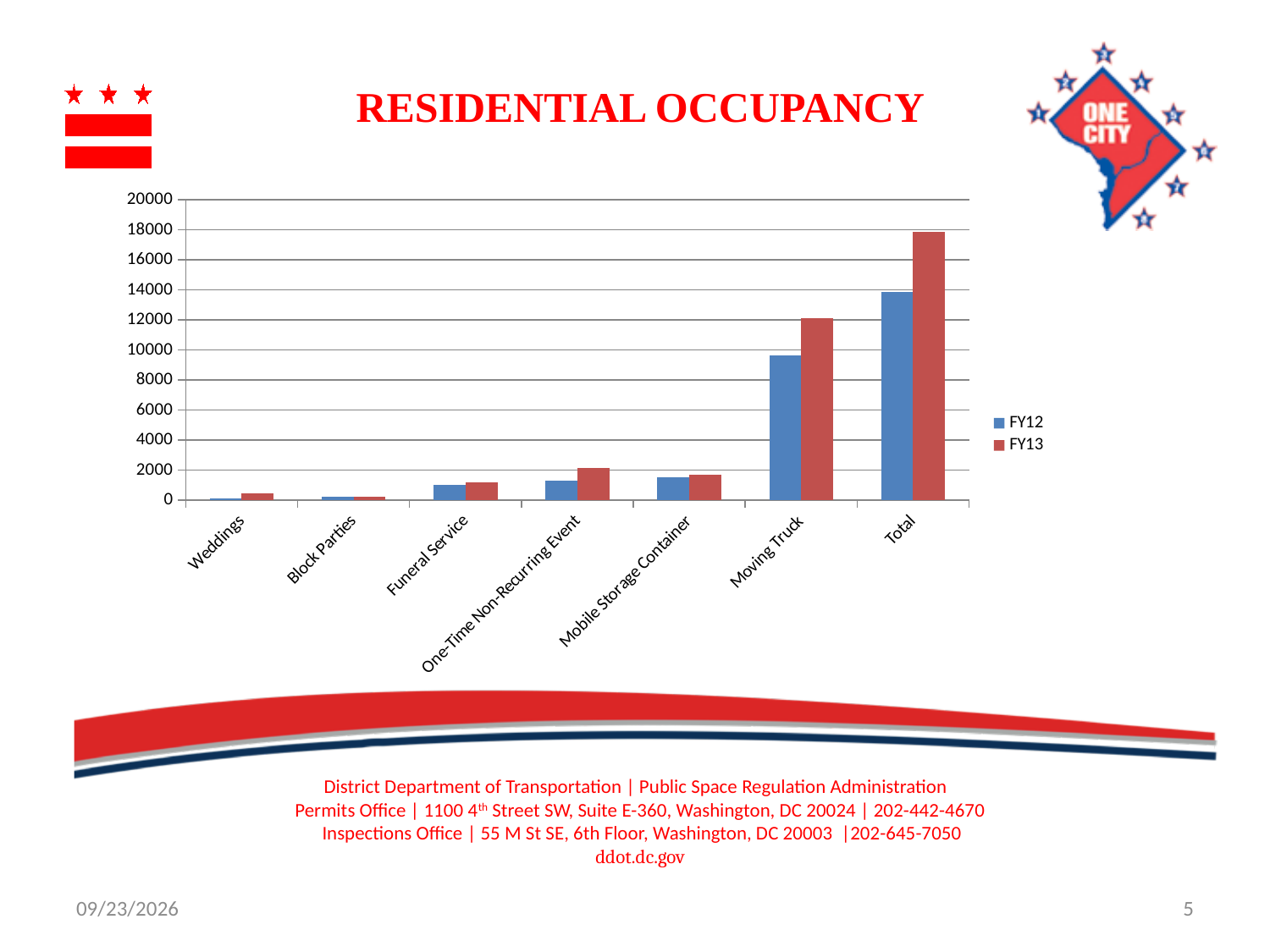
What is the title of the slide's chart? RESIDENTIAL OCCUPANCY How many series does the legend list? 2 Is the FY12 value for Total greater or less than 12000? greater Is the FY13 value for Weddings greater or less than 2000? less How many categories are shown on the x axis? 7 Which series is shown in red in the legend? FY13 What kind of chart is shown on the slide? bar chart Is the FY12 value for Moving Truck greater or less than 10000? less For Moving Truck, which is larger, the FY12 value or the FY13 value? FY13 Which category has the highest FY13 value? Total